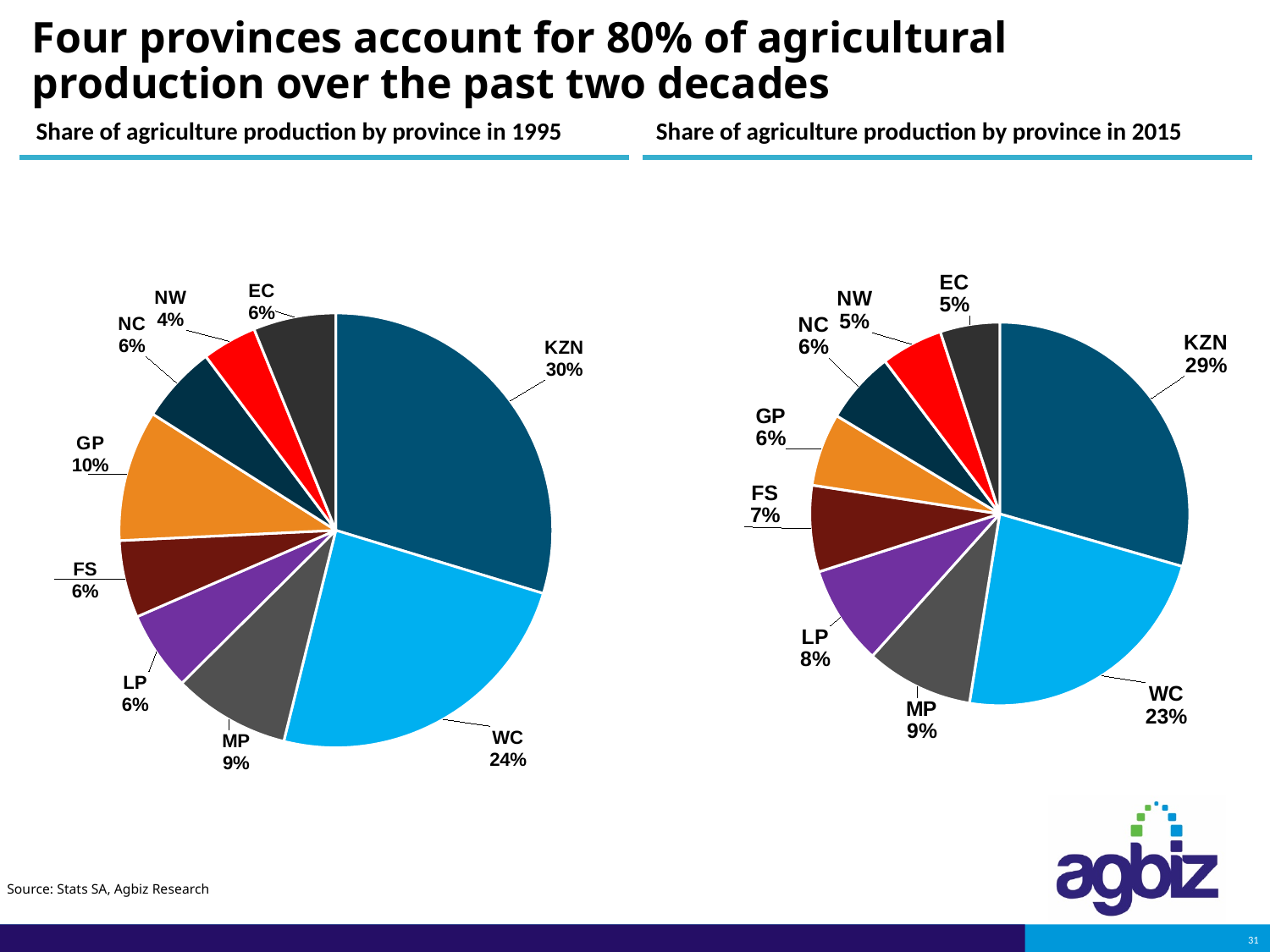
How many provinces are shown in the 2015 pie chart? 9 In the 2015 pie chart, which is larger, the share for MP or the share for FS? MP In the 1995 pie chart, what share of agriculture production does KZN have? 30% In the 2015 pie chart, which province has the largest share? KZN What type of chart is used to show the share of agriculture production by province in 1995? Pie chart In the 1995 pie chart, which province has the smallest share? NW In the 1995 pie chart, what is the share for GP? 10% In the 1995 pie chart, what is the difference between the shares of KZN and WC? 6% In the 1995 pie chart, which province has the largest share? KZN In the 2015 pie chart, what share of agriculture production does WC have? 23% In the 2015 pie chart, what is the share for LP? 8%